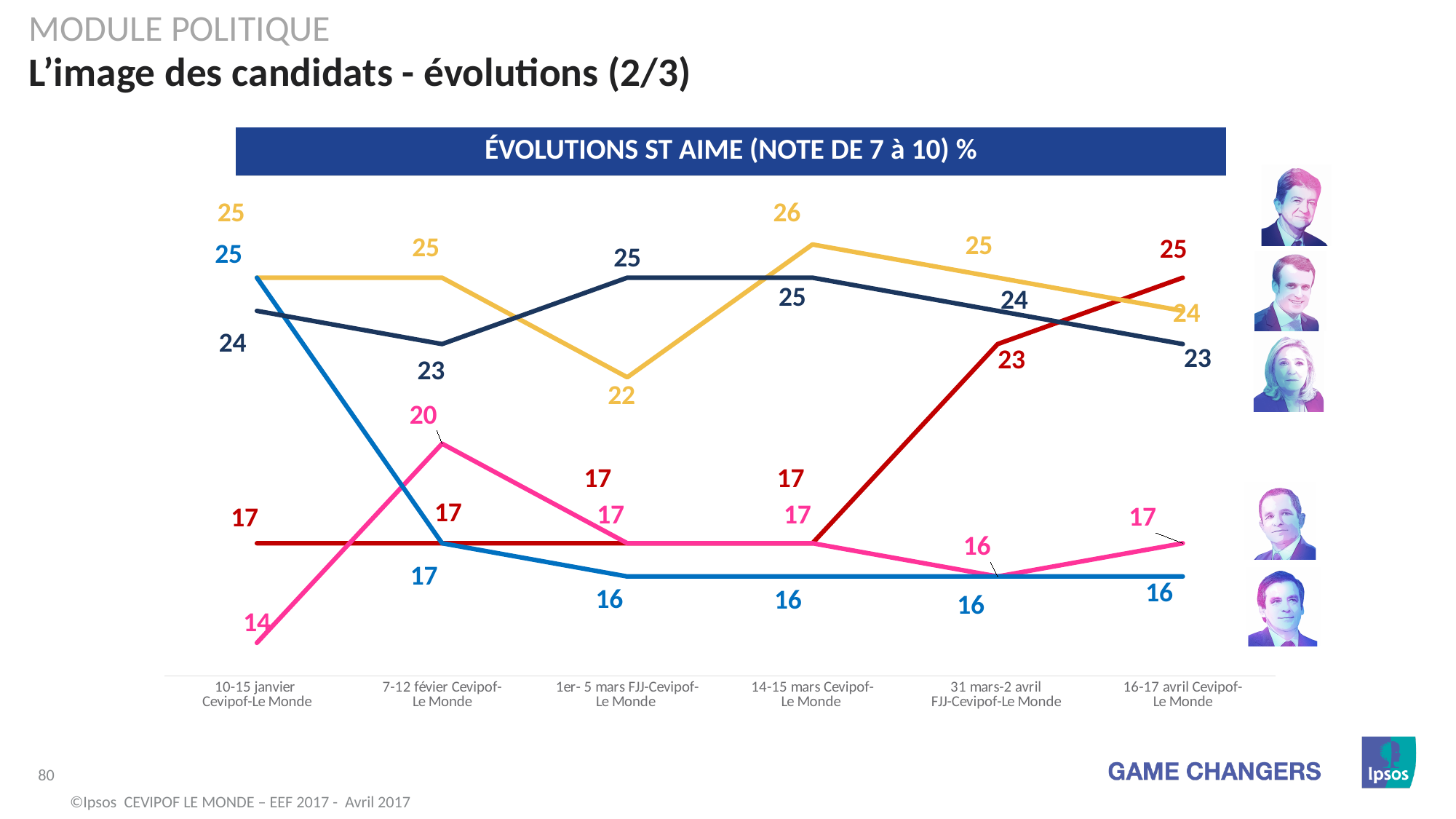
At which survey date does the red line reach its highest value? 16-17 avril Cevipof-Le Monde How many survey dates are shown along the x axis? 6 What is the title of the chart? ÉVOLUTIONS ST AIME (NOTE DE 7 à 10) % What is the value of the red line at 16-17 avril Cevipof-Le Monde? 25 What is the value of the yellow line at 14-15 mars Cevipof-Le Monde? 26 At 31 mars-2 avril FJJ-Cevipof-Le Monde, which is larger: the yellow line or the dark navy line? yellow line At which survey date does the yellow line reach its lowest value? 1er- 5 mars FJJ-Cevipof-Le Monde How many lines are plotted on the chart? 5 What kind of chart is shown on the slide? line chart What is the difference between the blue line's value at 10-15 janvier Cevipof-Le Monde and at 7-12 févier Cevipof-Le Monde? 8 What is the value of the pink line at 10-15 janvier Cevipof-Le Monde? 14 Does the red line rise or fall between 14-15 mars Cevipof-Le Monde and 16-17 avril Cevipof-Le Monde? rise